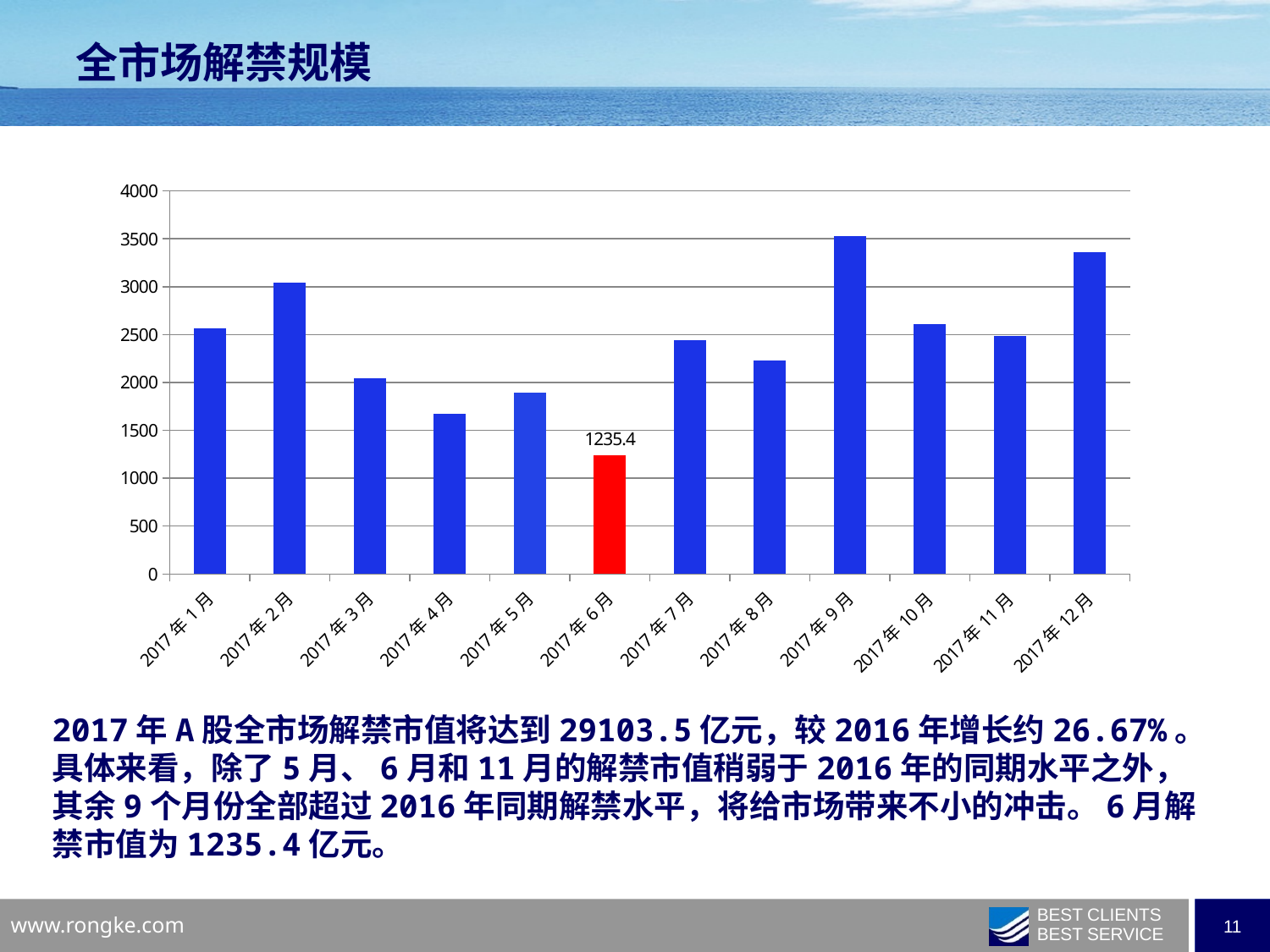
Which is larger, the value for 2017年2月 or 2017年12月? 2017年12月 Is the value for 2017年12月 greater or less than 3000? greater Is the value for 2017年4月 greater or less than 2000? less How many months are shown on the x axis? 12 Is the value for 2017年8月 greater or less than 2000? greater Which month has the lowest value? 2017年6月 Which month has the highest value? 2017年9月 Which is larger, the value for 2017年4月 or 2017年5月? 2017年5月 What is the value for 2017年6月? 1235.4 What kind of chart is shown on the slide? bar chart Which month's bar is coloured red? 2017年6月